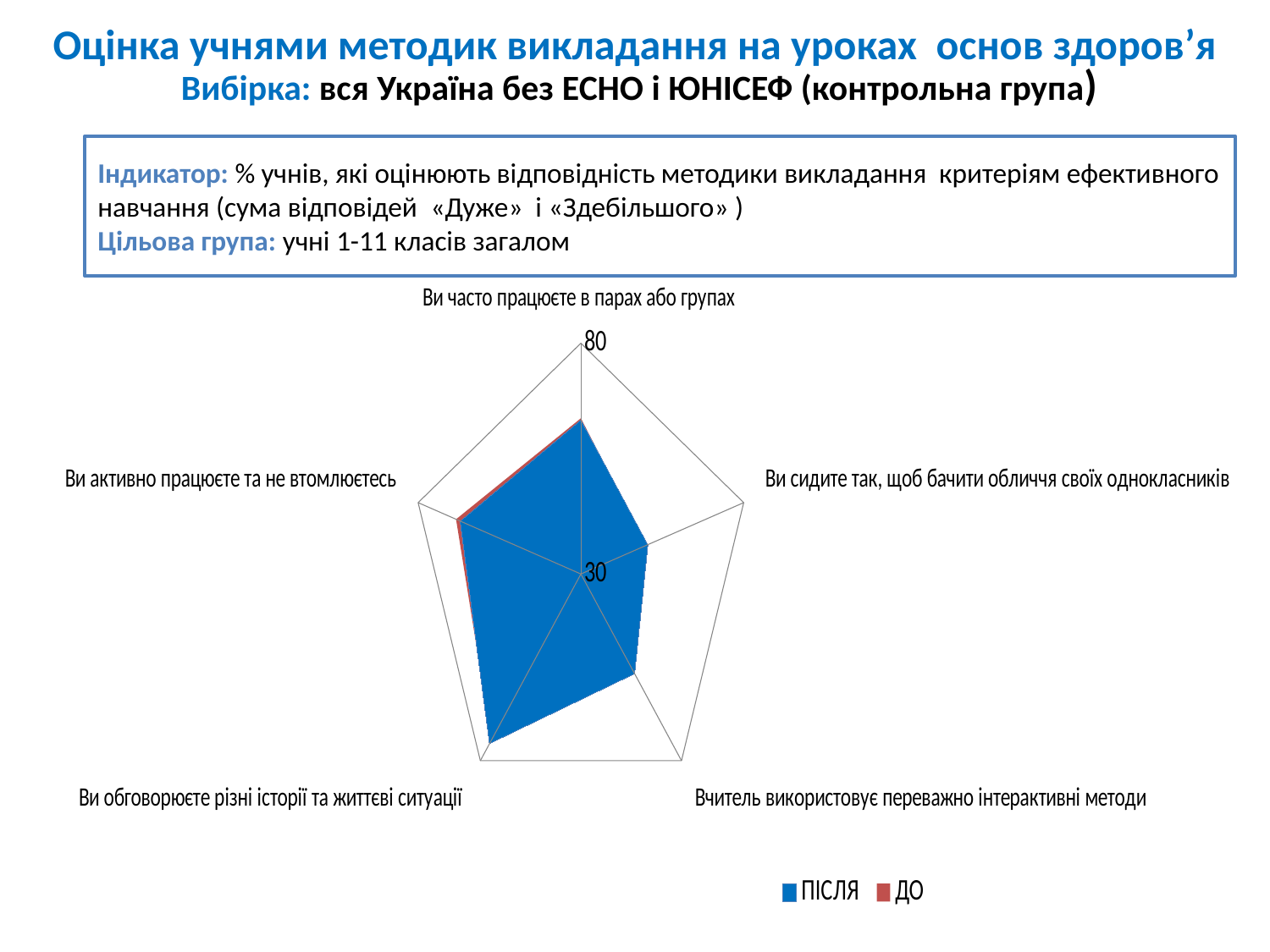
What kind of chart is shown on the slide? radar chart Is the ПІСЛЯ value for 'Ви часто працюєте в парах або групах' greater or less than 80? less For the ПІСЛЯ series, which is larger: 'Ви активно працюєте та не втомлюєтесь' or 'Ви сидите так, щоб бачити обличчя своїх однокласників'? Ви активно працюєте та не втомлюєтесь For the ПІСЛЯ series, which is larger: 'Ви часто працюєте в парах або групах' or 'Вчитель використовує переважно інтерактивні методи'? Ви часто працюєте в парах або групах Which category has the highest value for the ПІСЛЯ series? Ви обговорюєте різні історії та життєві ситуації Which colour represents the series ПІСЛЯ? blue Is the ПІСЛЯ value for 'Ви сидите так, щоб бачити обличчя своїх однокласників' greater or less than 30? greater Is the ПІСЛЯ value for 'Ви обговорюєте різні історії та життєві ситуації' greater or less than 30? greater How many categories (axes) does the radar chart have? 5 How many series does the legend list? 2 What are the two series named in the legend? ПІСЛЯ and ДО Which category has the lowest value for the ПІСЛЯ series? Ви сидите так, щоб бачити обличчя своїх однокласників